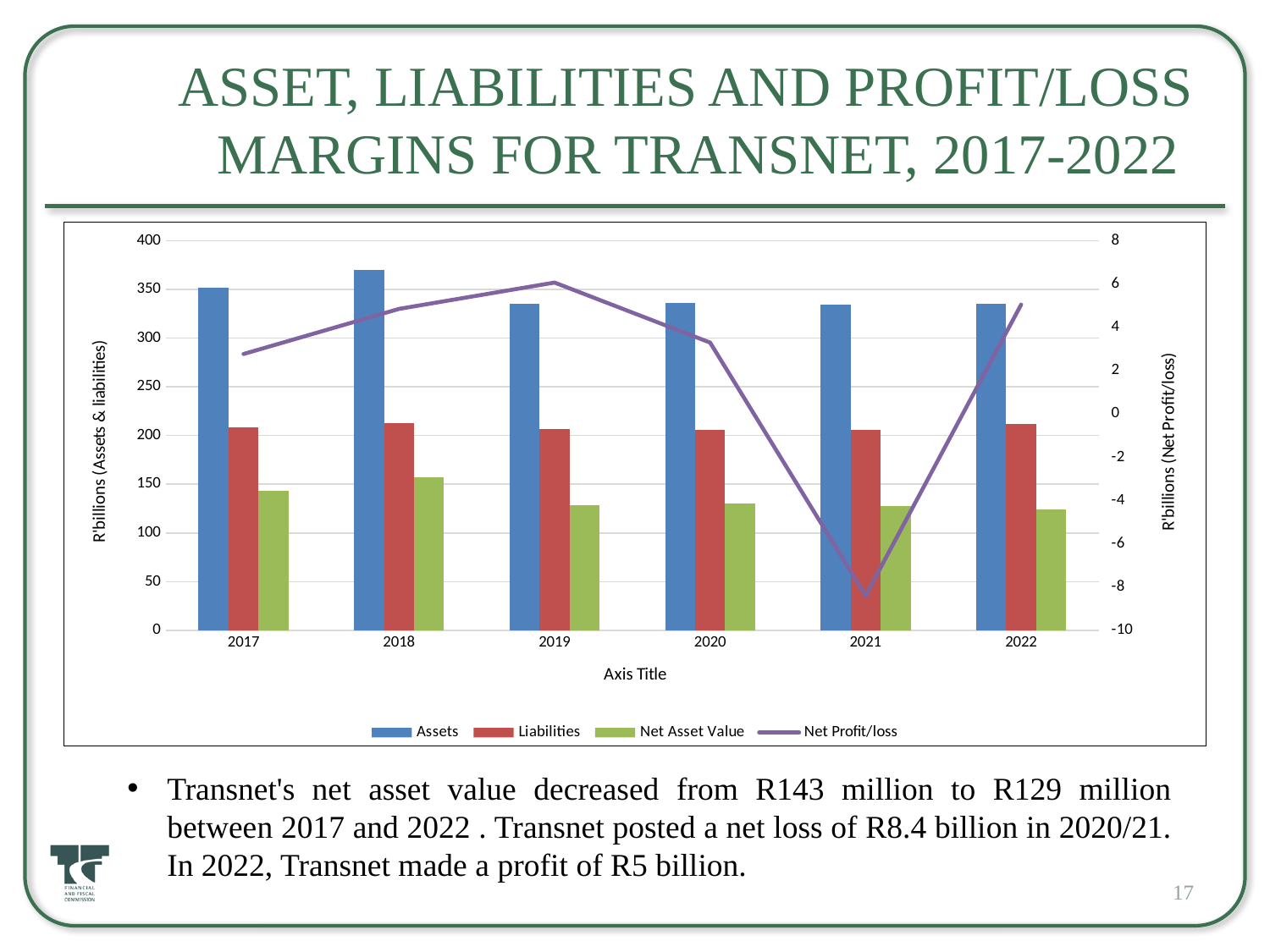
Which is larger in 2020, Assets or Liabilities? Assets How many series does the chart's legend list? 4 What is the label on the left vertical axis of the chart? R'billions (Assets & liabilities) Does the Net Profit/loss line rise or fall between 2019 and 2021? Falls In which year are Assets highest? 2018 How many years are shown on the x axis of the chart? 6 Is the value for Net Profit/loss in 2019 greater or less than 4? greater What kind of chart is shown on the slide? A combination bar and line chart In which year is Net Asset Value highest? 2018 In which year is Net Profit/loss lowest? 2021 Is the value for Net Asset Value in 2022 greater or less than 150? less Is the value for Assets in 2018 greater or less than 350? greater